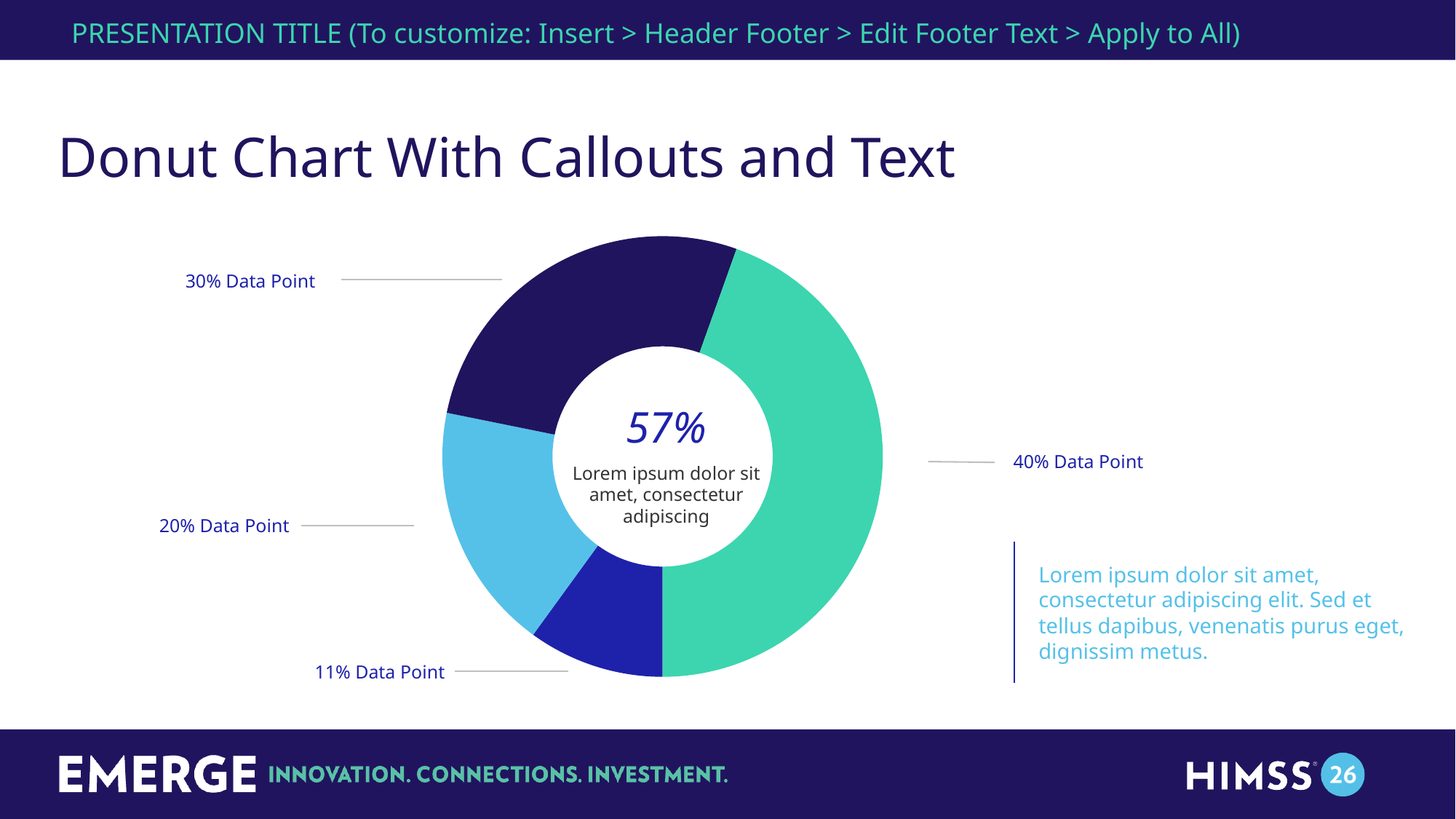
What percentage is displayed in the centre of the donut chart? 57% How many segments does the donut chart have? 4 Which segment of the donut chart is the largest? 40% Data Point What value is labelled on the segment at the bottom of the donut chart? 11% Which segment of the donut chart is the smallest? 11% Data Point What is the difference between the 30% Data Point segment and the 20% Data Point segment? 10 percentage points What value is labelled on the segment on the right side of the donut chart? 40% What is the title of the slide containing the donut chart? Donut Chart With Callouts and Text What kind of chart is shown on the slide? donut chart Which is larger, the 20% Data Point segment or the 11% Data Point segment? 20% Data Point What colour is the largest segment of the donut chart? teal green